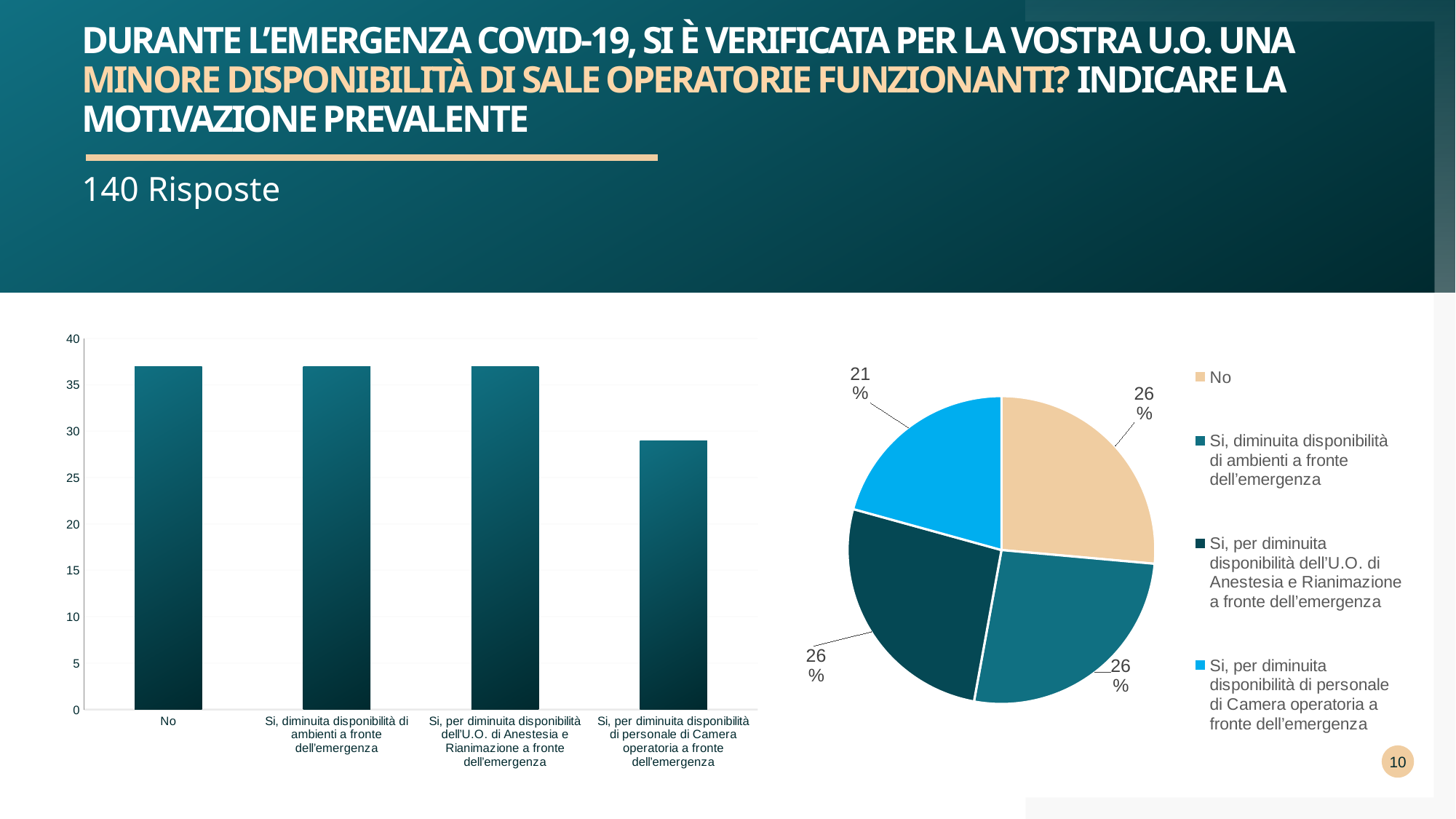
In the bar chart on the left, which is larger: the bar for "No" or the bar for "Si, per diminuita disponibilità di personale di Camera operatoria a fronte dell'emergenza"? No How many entries does the legend of the pie chart on the right list? 4 In the bar chart on the left, how many categories are shown on the x axis? 4 What kind of chart is the chart on the right of the slide? pie chart In the pie chart on the right, what is the difference between the "No" share and the "Si, per diminuita disponibilità di personale di Camera operatoria a fronte dell'emergenza" share? 5% What kind of chart is the chart on the left of the slide? bar chart In the bar chart on the left, is the value for "Si, per diminuita disponibilità di personale di Camera operatoria a fronte dell'emergenza" greater or less than 30? less In the pie chart on the right, what share does the "Si, per diminuita disponibilità di personale di Camera operatoria a fronte dell'emergenza" slice have? 21% In the pie chart on the right, what share does the "No" slice have? 26% In the pie chart on the right, which slice is the smallest? Si, per diminuita disponibilità di personale di Camera operatoria a fronte dell'emergenza In the bar chart on the left, is the value for "No" greater or less than 35? greater In the bar chart on the left, which category has the lowest bar? Si, per diminuita disponibilità di personale di Camera operatoria a fronte dell'emergenza